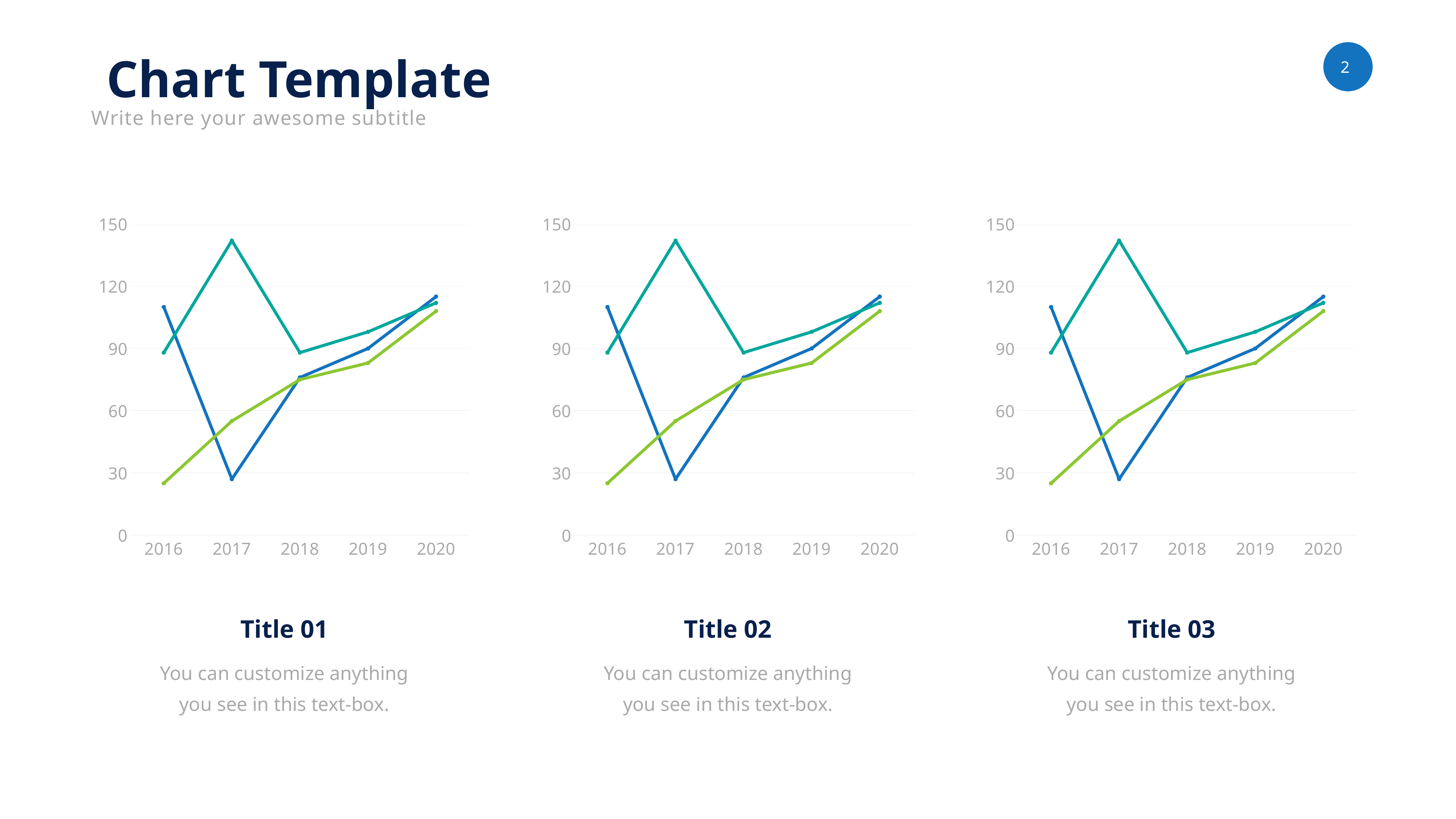
In the chart labelled Title 03, is the value of the green line in 2016 greater or less than 60? less In the chart labelled Title 01, is the value of the teal line in 2017 greater or less than 120? greater In the chart labelled Title 03, is the value of the blue line in 2016 greater or less than 90? greater In the chart labelled Title 01, how many years are shown on the x axis? 5 In the chart labelled Title 01, does the green line rise or fall from 2016 to 2020? rise In the chart labelled Title 03, in 2017, which is larger: the teal line or the blue line? the teal line What is the highest value shown on the y axis of the chart labelled Title 02? 150 In the chart labelled Title 02, in which year does the blue line reach its lowest value? 2017 In the chart labelled Title 02, how many lines are plotted? 3 What kind of chart is the chart labelled Title 01? line chart In the chart labelled Title 01, in which year does the teal line reach its highest value? 2017